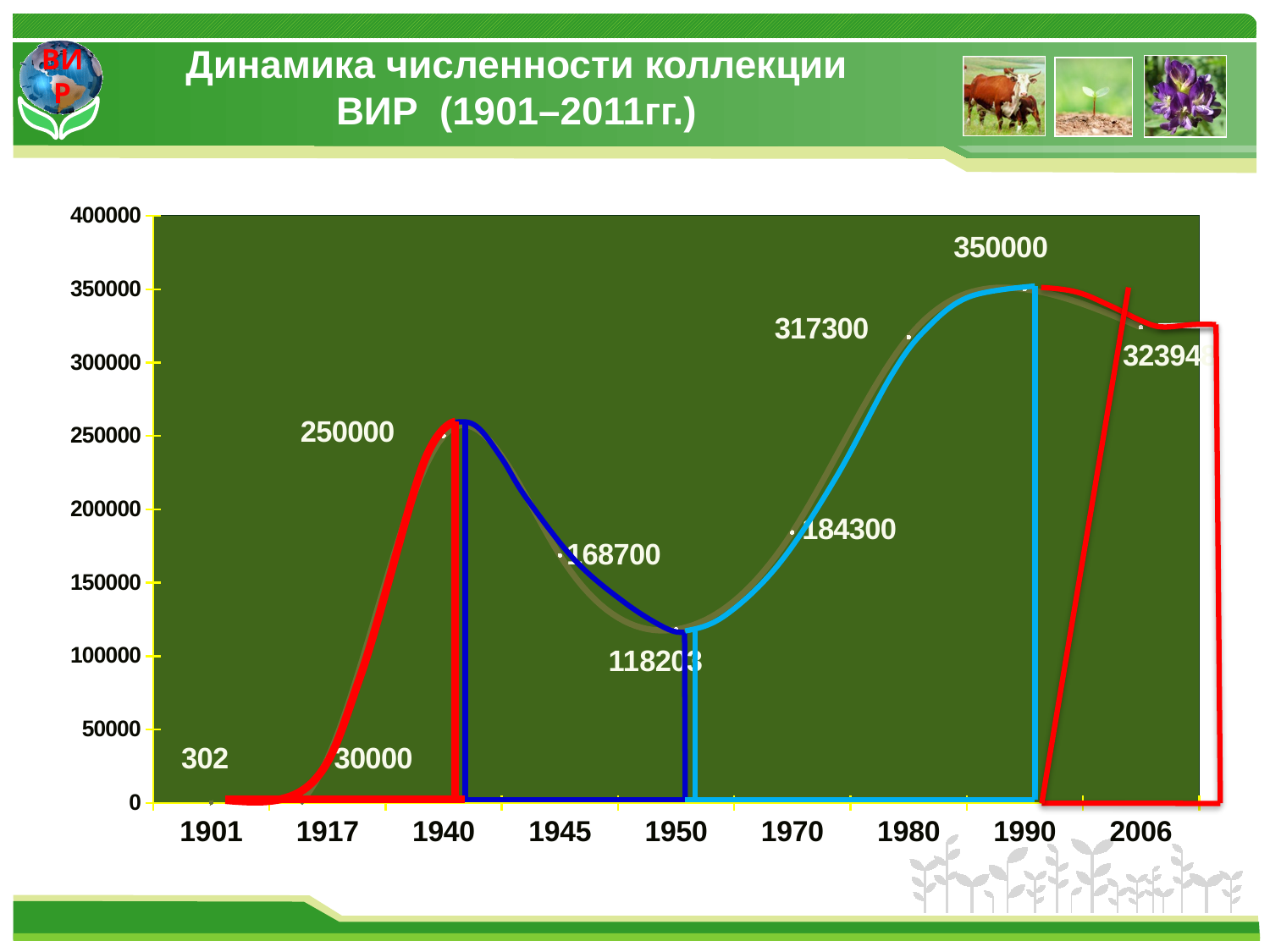
Which is larger, the value for 1945 or the value for 1970? 1970 What is the difference between the values for 1940 and 1945? 81300 What is the difference between the values for 1990 and 1980? 32700 What is the value shown for 1950? 118203 What is the value shown for 1980? 317300 What kind of chart is shown on the slide? line chart What is the value shown for 1901? 302 Do the values rise or fall between 1950 and 1990? rise Which year has the highest value on the chart? 1990 Is the value for 1950 greater or less than 150000? less Which year has the lowest value on the chart? 1901 What is the value shown for 1940? 250000